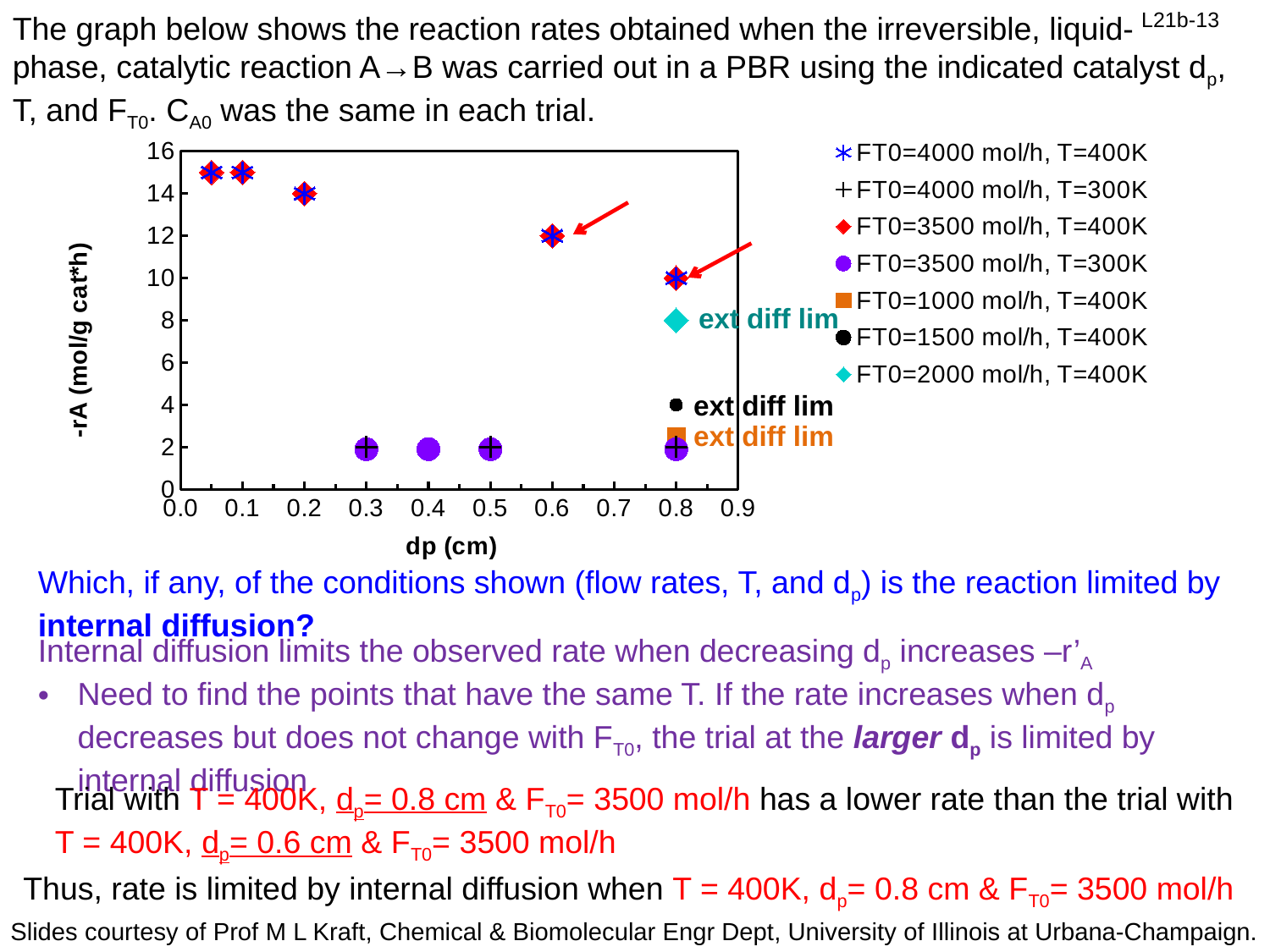
Is the value for the FT0=1500 mol/h, T=400K point greater or less than 6? less For the FT0=3500 mol/h, T=400K series, does the rate rise or fall as dp increases? falls Is the value for the FT0=2000 mol/h, T=400K point greater or less than 6? greater Is the value for the FT0=3500 mol/h, T=400K series at dp = 0.6 cm greater or less than 10? greater What kind of chart is shown on the slide? scatter chart How many series does the chart legend list? 7 What is the title of the x axis of the chart? dp (cm) For the FT0=3500 mol/h, T=400K series, at which dp value is the rate lowest? 0.8 What is the title of the y axis of the chart? -rA (mol/g cat*h) At dp = 0.8 cm, which has the higher rate: the FT0=3500 mol/h, T=400K point or the FT0=2000 mol/h, T=400K point? FT0=3500 mol/h, T=400K